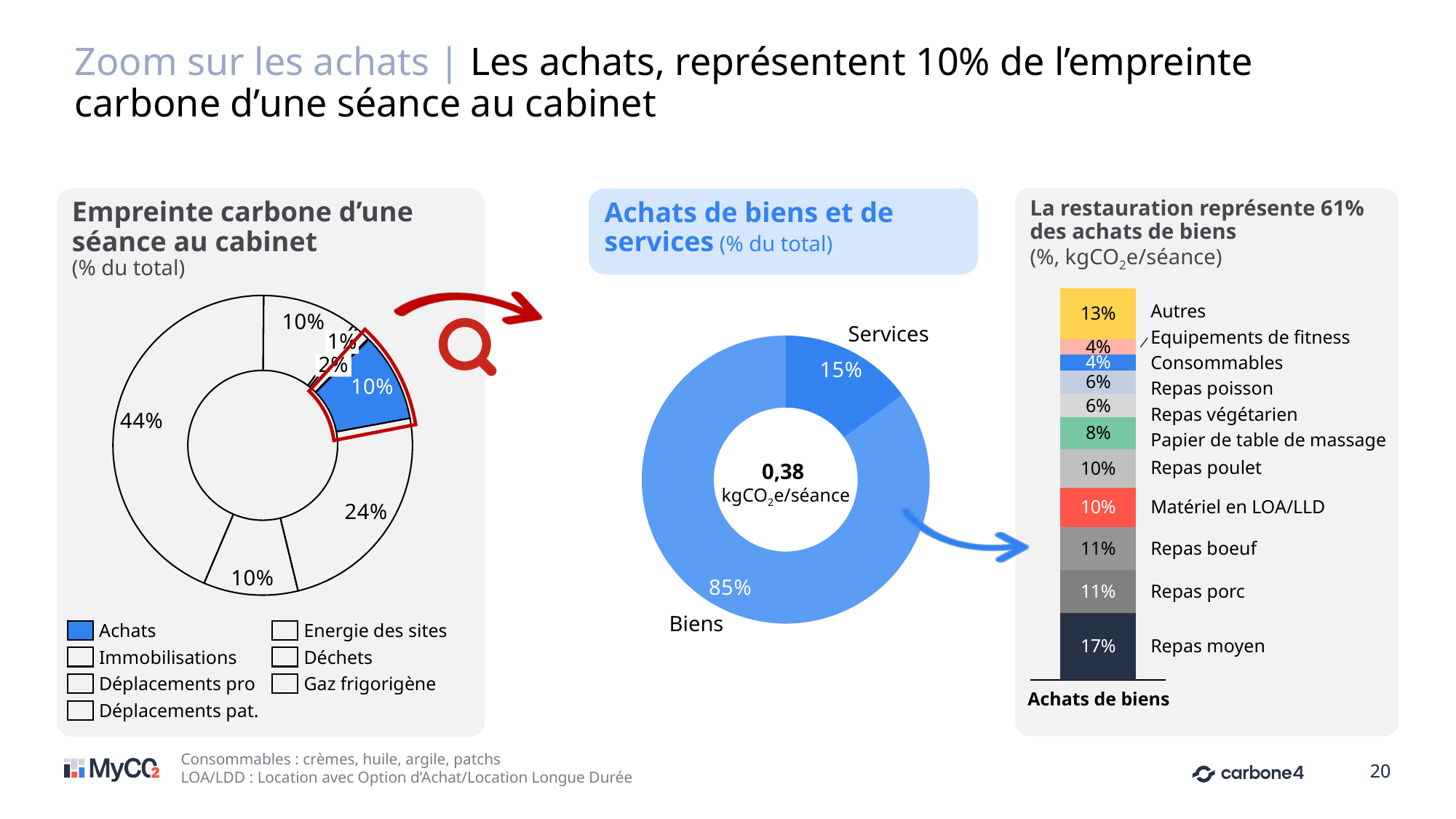
How many segments make up the stacked bar in the chart on the right? 11 In the 'Achats de biens et de services' donut chart, what value is shown in the centre of the donut? 0,38 kgCO2e/séance In the stacked bar chart on the right, what share is Papier de table de massage? 8% In the 'Achats de biens et de services' donut chart, what share is Biens? 85% In the 'Empreinte carbone d'une séance au cabinet' donut chart, what share is Achats (the blue segment)? 10% In the stacked bar chart on the right, which segment is the largest? Repas moyen In the 'Achats de biens et de services' donut chart, what share is Services? 15% In the 'Empreinte carbone d'une séance au cabinet' donut chart, what is the value of the largest segment? 44% In the stacked bar chart on the right ('La restauration représente 61% des achats de biens'), what share is Repas moyen? 17% How many entries does the legend of the 'Empreinte carbone d'une séance au cabinet' chart list? 7 In the stacked bar chart on the right, which is larger: Repas boeuf or Repas poisson? Repas boeuf In the 'Achats de biens et de services' donut chart, what is the difference in percentage points between Biens and Services? 70 percentage points